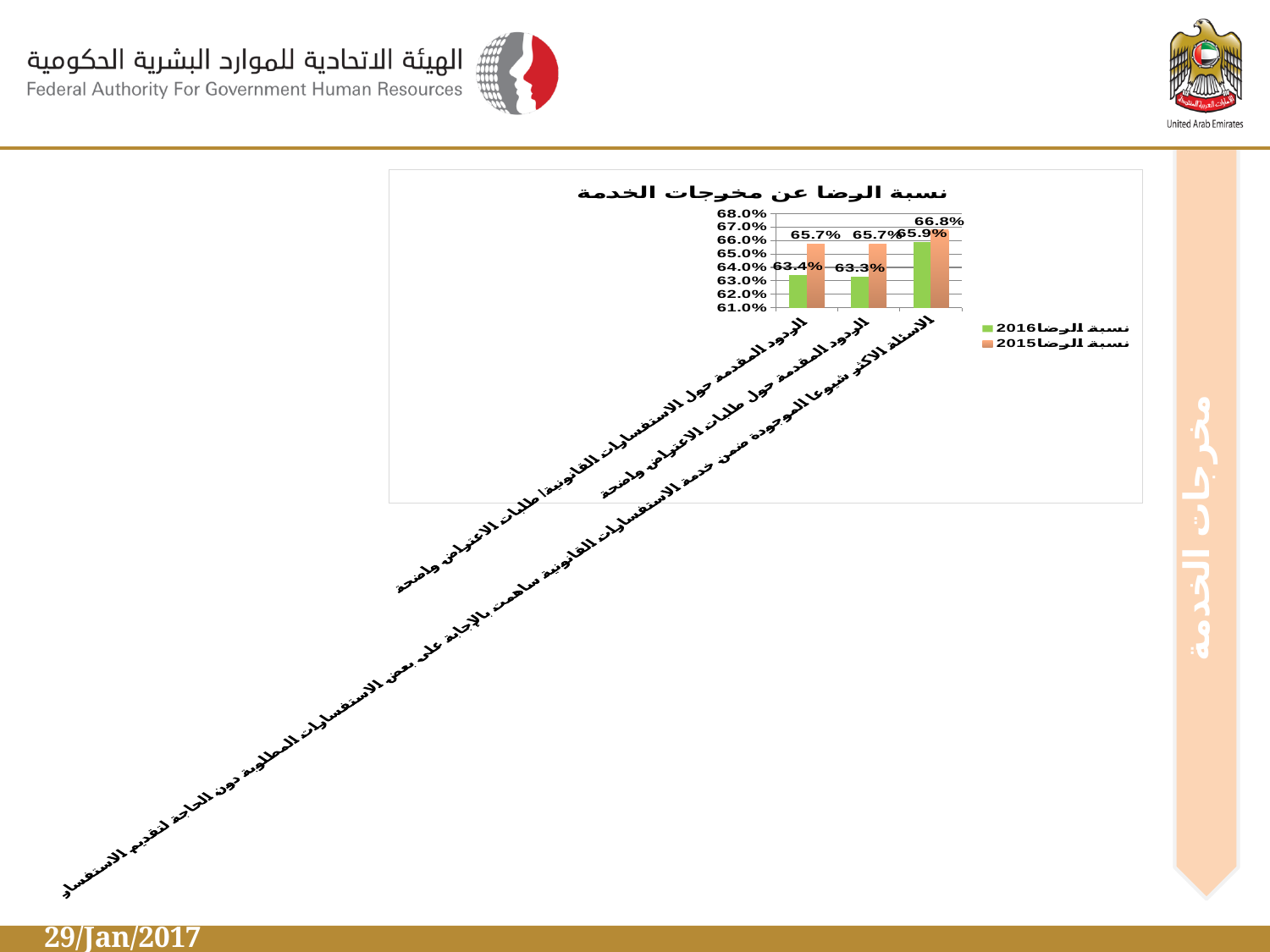
Which category has the lowest value for نسبة الرضا 2016? the second (middle) category What is the value of نسبة الرضا 2016 for the first (leftmost) category? 63.4% How many series does the chart legend list? 2 What is the value of نسبة الرضا 2015 for the first (leftmost) category? 65.7% What kind of chart is shown on the slide? bar chart For the third (rightmost) category, which is larger: نسبة الرضا 2016 or نسبة الرضا 2015? نسبة الرضا 2015 Which category has the highest value for نسبة الرضا 2016? the third (rightmost) category How many categories are plotted on the x axis of the chart? 3 What is the value of نسبة الرضا 2015 for the third (rightmost) category? 66.8% What is the difference between نسبة الرضا 2015 and نسبة الرضا 2016 for the first (leftmost) category? 2.3% What is the value of نسبة الرضا 2016 for the second (middle) category? 63.3% What is the title of the chart? نسبة الرضا عن مخرجات الخدمة